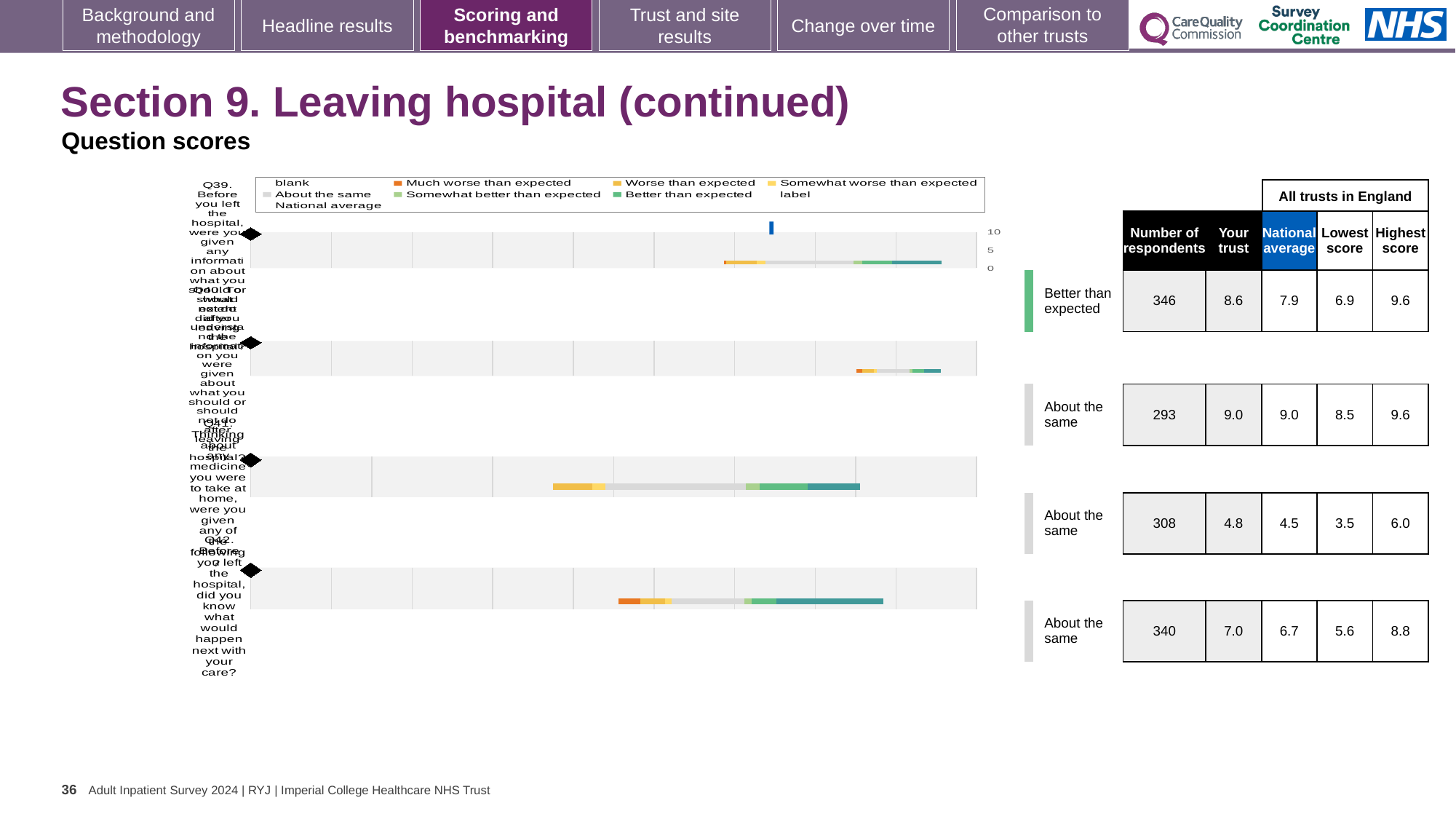
In the table beside the chart, what is the National average for the row labelled 'Better than expected'? 7.9 In the table beside the chart, what is the 'Your trust' score for the row labelled 'Better than expected'? 8.6 In the table beside the chart, what is the lowest 'Your trust' score shown? 4.8 In the table beside the chart, how many respondents are listed for the row labelled 'Better than expected'? 346 In the chart legend, what colour represents 'Much worse than expected'? orange How many question bars (Q39 to Q42) are plotted in the chart? 4 In the table beside the chart, for the row with 308 respondents, what is the difference between the highest score and the lowest score? 2.5 In the table beside the chart, for the row with 340 respondents, which is larger: the 'Your trust' score or the National average? Your trust What kind of chart is shown on the slide? bar chart In the table beside the chart, what is the highest 'Your trust' score shown? 9.0